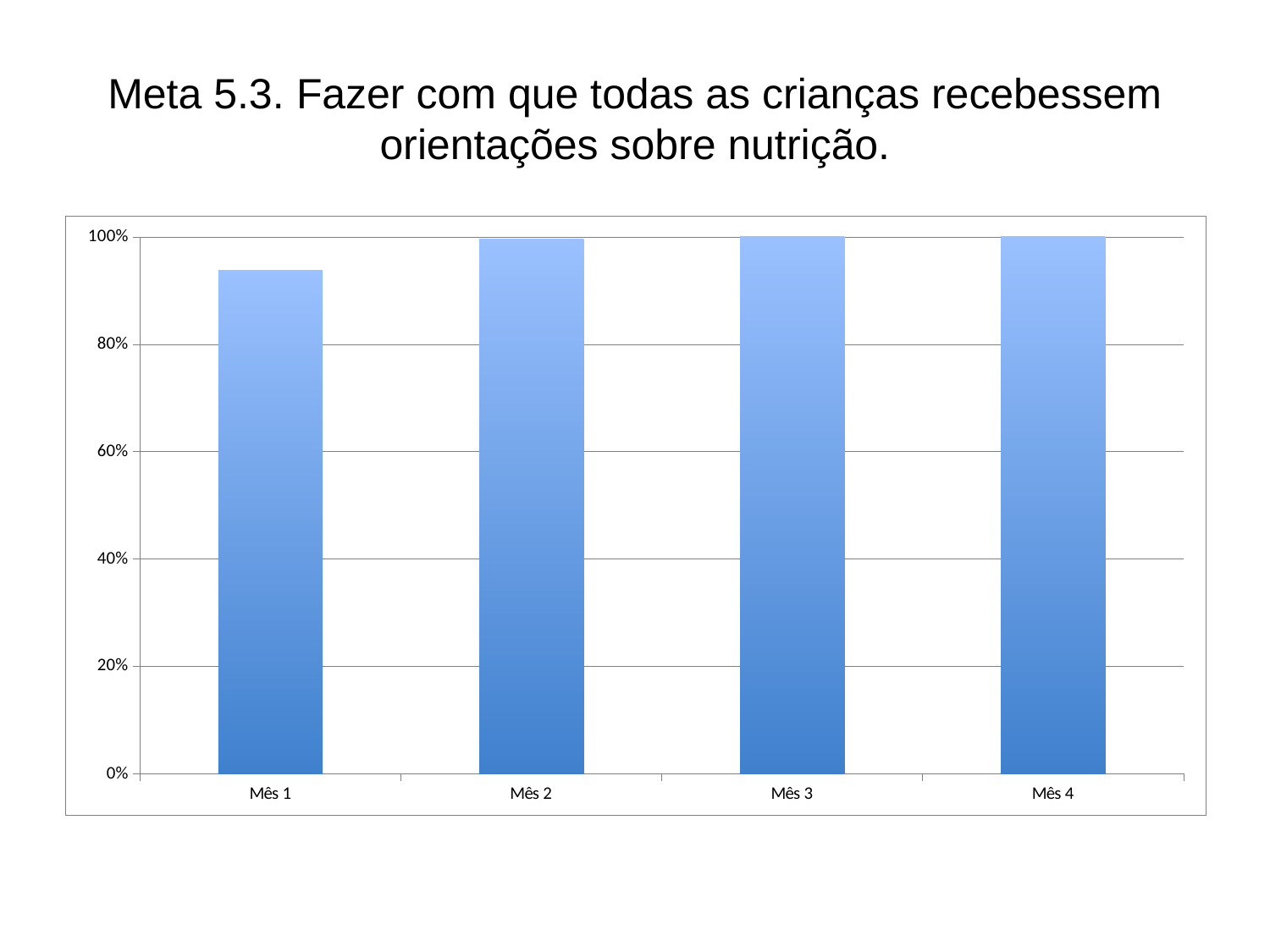
Is the value for Mês 1 greater or less than 100%? less What is the highest value shown on the y axis of the chart? 100% What kind of chart is shown on the slide? bar chart What is the label of the first category on the x axis? Mês 1 Which month has the lowest value in the chart? Mês 1 What is the value for Mês 4? 100% Is the value for Mês 1 greater or less than 80%? greater Which is larger, the value for Mês 1 or the value for Mês 4? Mês 4 How many categories are shown on the x axis of the chart? 4 Do the values generally rise or fall from Mês 1 to Mês 4? rise Which is larger, the value for Mês 1 or the value for Mês 2? Mês 2